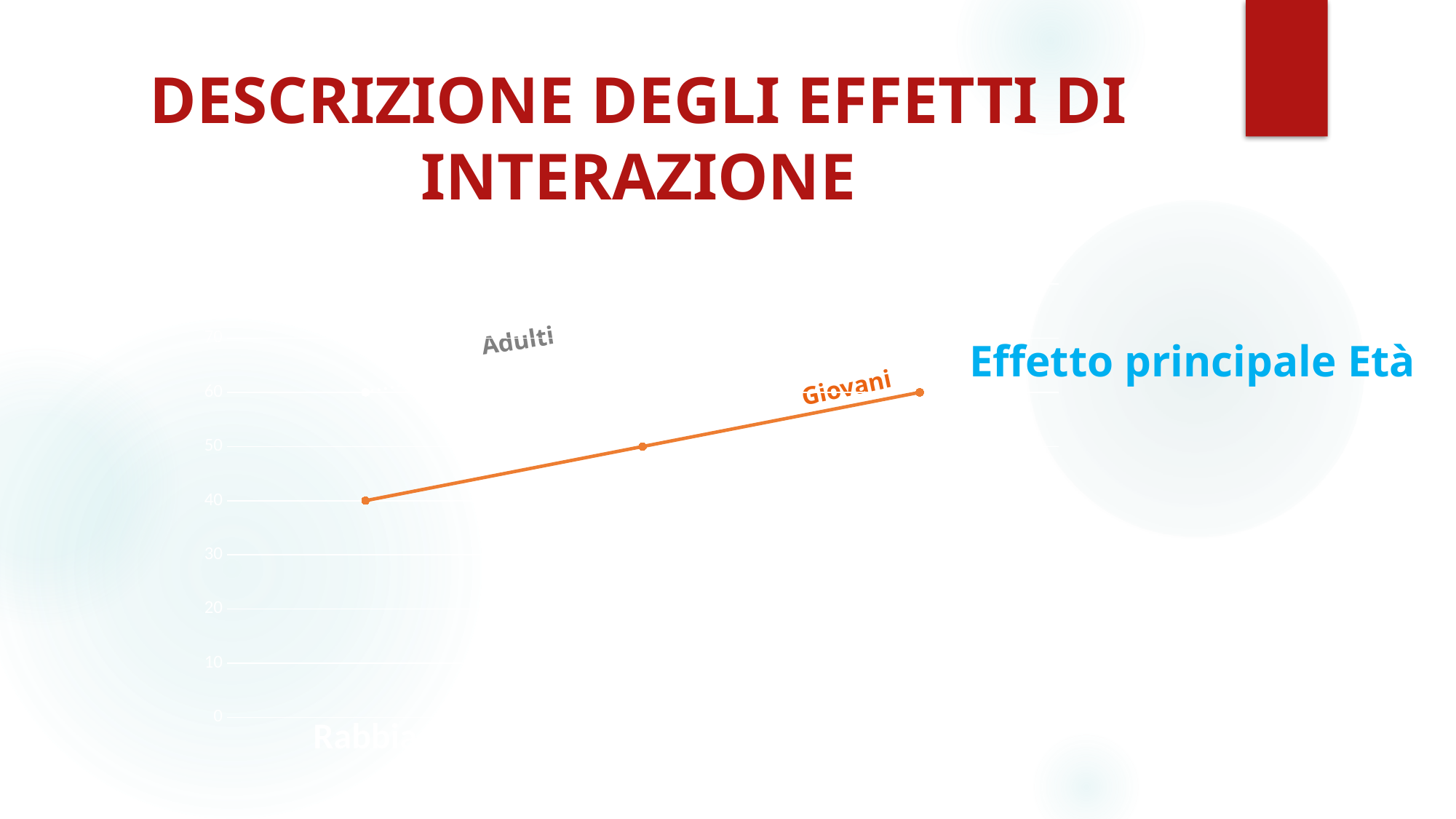
Which is larger on the Giovani line: the leftmost point or the middle point? the middle point Does the Giovani line rise or fall from left to right? rise Is the value of the rightmost point on the Giovani line greater or less than 50? greater What is the value of the leftmost point on the Giovani line? 40 What is the value of the rightmost point on the Giovani line? 60 How many data points are plotted on the Giovani line? 3 What kind of chart is shown on the slide? line chart What is the difference between the rightmost and leftmost values on the Giovani line? 20 Which point on the Giovani line is the highest: the leftmost, middle or rightmost? rightmost What colour is the Giovani line? orange What is the value of the middle point on the Giovani line? 50 What text in blue appears to the right of the chart? Effetto principale Età